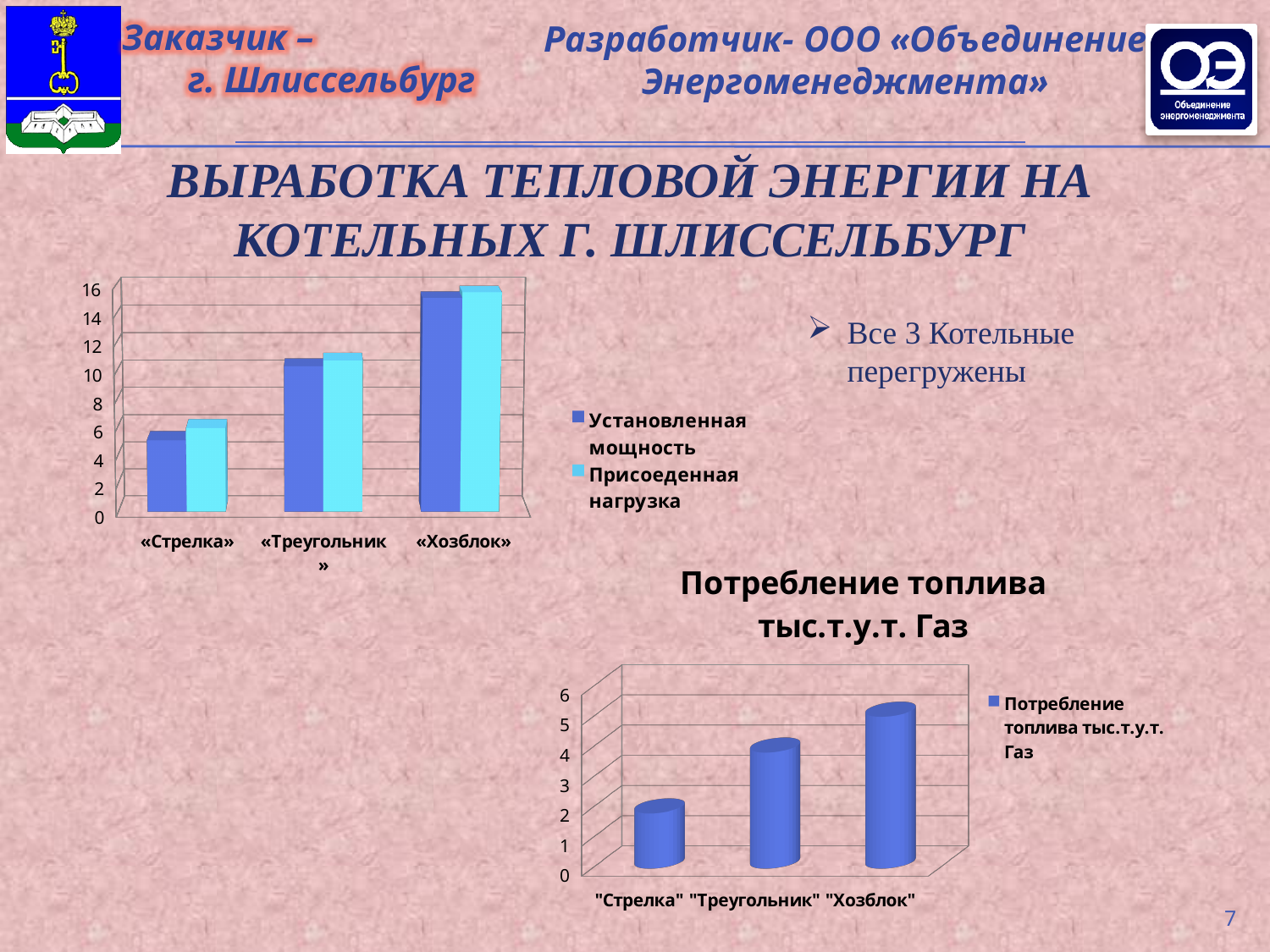
In the top-left chart, which boiler house has the highest «Установленная мощность»? «Хозблок» In the chart titled «Потребление топлива тыс.т.у.т. Газ», is the value for "Стрелка" greater or less than 3? less How many series does the legend of the top-left chart list? 2 In the chart titled «Потребление топлива тыс.т.у.т. Газ», do the values rise or fall from "Стрелка" to "Хозблок"? rise What kind of chart is the chart titled «Потребление топлива тыс.т.у.т. Газ»? bar chart In the chart titled «Потребление топлива тыс.т.у.т. Газ», is the value for "Хозблок" greater or less than 4? greater In the top-left chart, is the «Установленная мощность» for «Хозблок» greater or less than 14? greater What are the two legend entries of the top-left chart? Установленная мощность; Присоеденная нагрузка How many boiler houses (categories) are shown on the x axis of the chart titled «Потребление топлива тыс.т.у.т. Газ»? 3 In the chart titled «Потребление топлива тыс.т.у.т. Газ», which boiler house has the lowest fuel consumption? "Стрелка" In the top-left chart, for «Стрелка», which is larger: «Установленная мощность» or «Присоеденная нагрузка»? «Присоеденная нагрузка» In the chart titled «Потребление топлива тыс.т.у.т. Газ», which boiler house has the highest fuel consumption? "Хозблок"